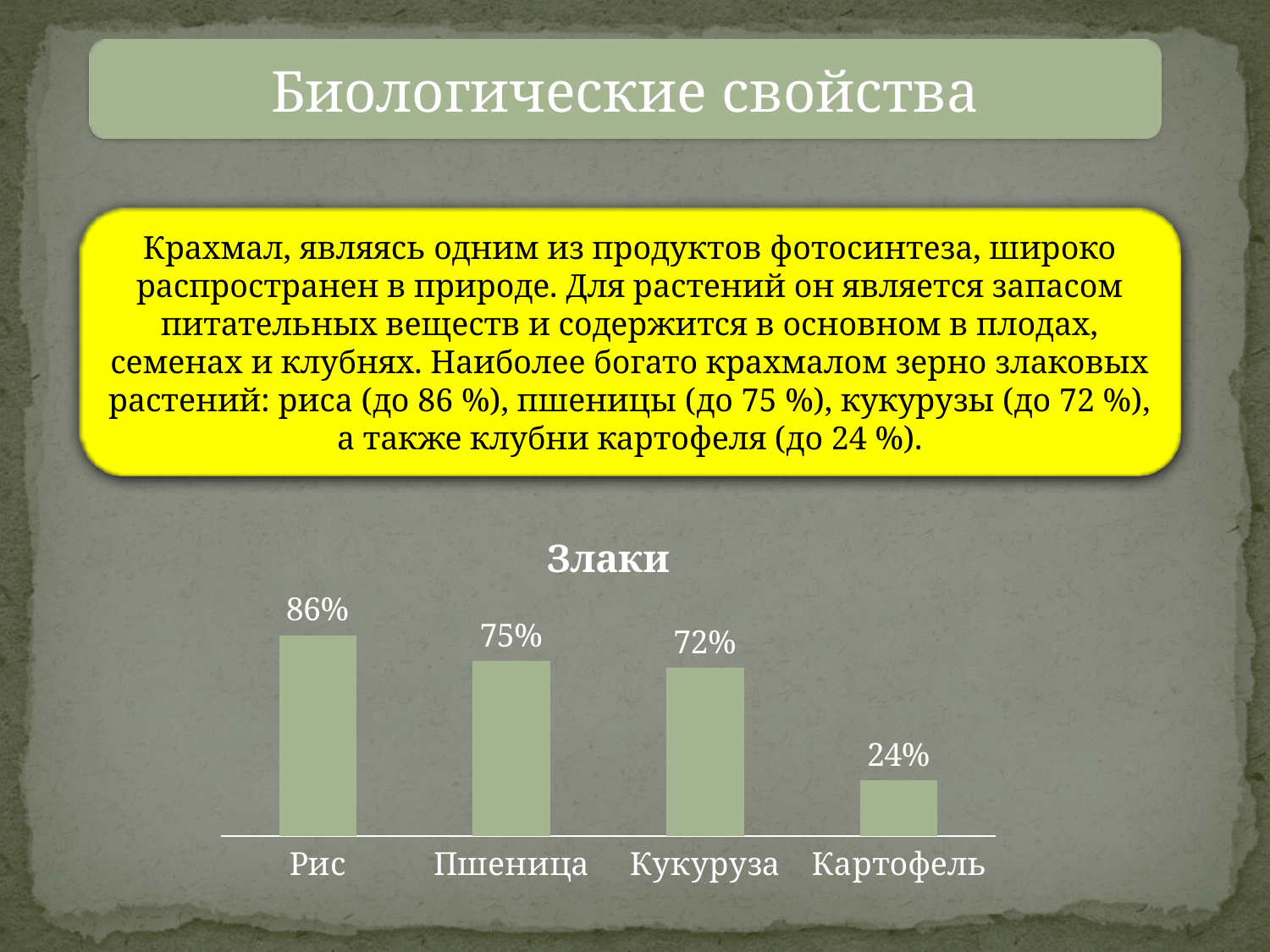
Which is larger in the Злаки chart, the value for Рис or the value for Пшеница? Рис Which category has the highest value in the Злаки chart? Рис What is the difference between the values for Пшеница and Кукуруза in the Злаки chart? 3% Which category has the lowest value in the Злаки chart? Картофель Do the values in the Злаки chart rise or fall from left to right along the x axis? Fall What is the difference between the values for Рис and Картофель in the Злаки chart? 62% What kind of chart is the Злаки chart? Bar chart How many categories are shown in the Злаки chart? 4 What is the value for Кукуруза in the Злаки chart? 72% What is the value for Рис in the Злаки chart? 86% What is the value for Пшеница in the Злаки chart? 75% What is the value for Картофель in the Злаки chart? 24%